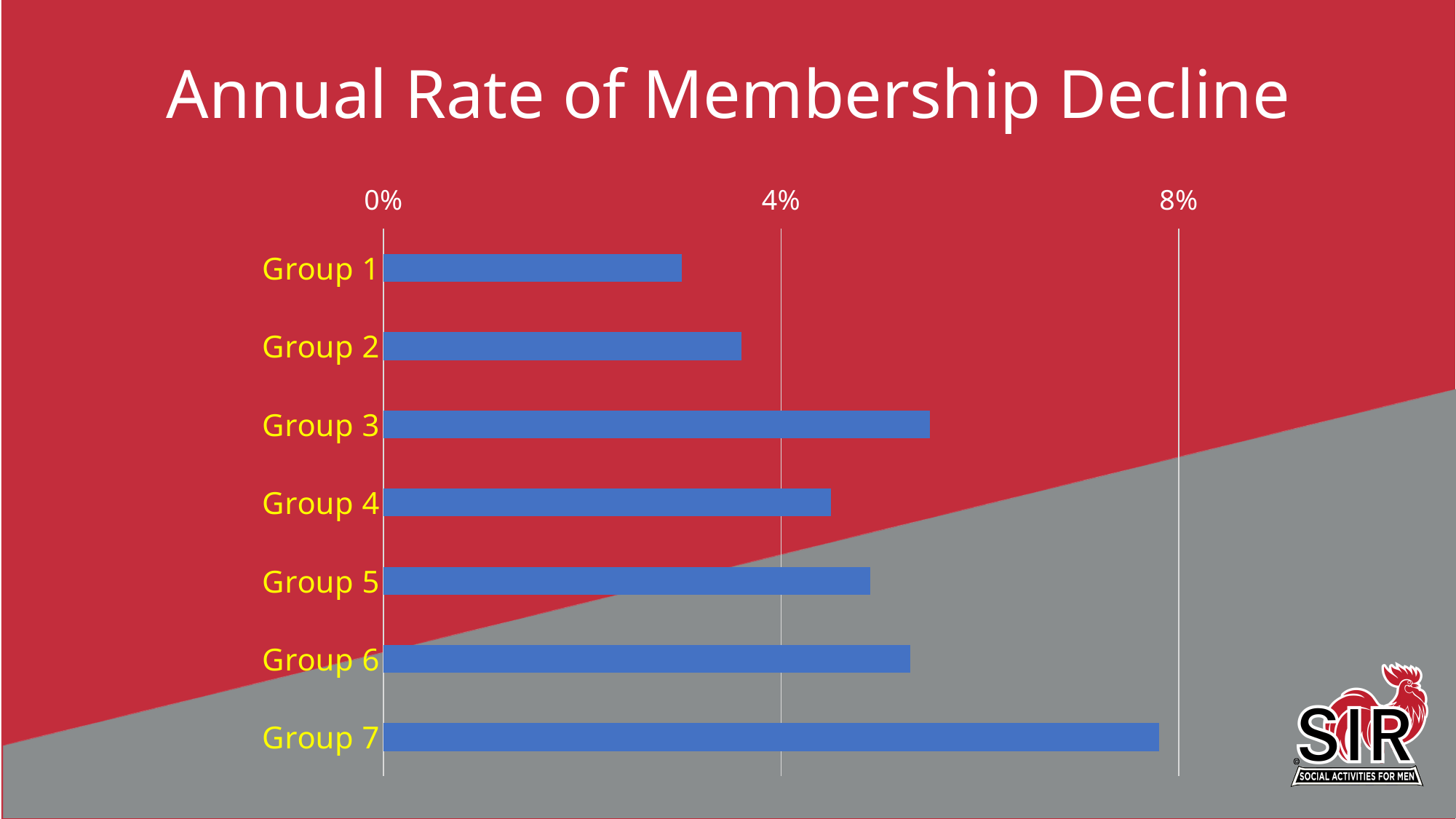
What kind of chart is shown on the slide? bar chart Which has a larger value, Group 1 or Group 2? Group 2 How many groups are plotted in the chart? 7 Is the value for Group 3 greater or less than 4%? greater Which group has the highest annual rate of membership decline? Group 7 Which has a larger value, Group 4 or Group 7? Group 7 Which has a larger value, Group 3 or Group 4? Group 3 Which group has the lowest annual rate of membership decline? Group 1 Is the value for Group 1 greater or less than 4%? less What is the title of the chart? Annual Rate of Membership Decline Is the value for Group 2 greater or less than 4%? less